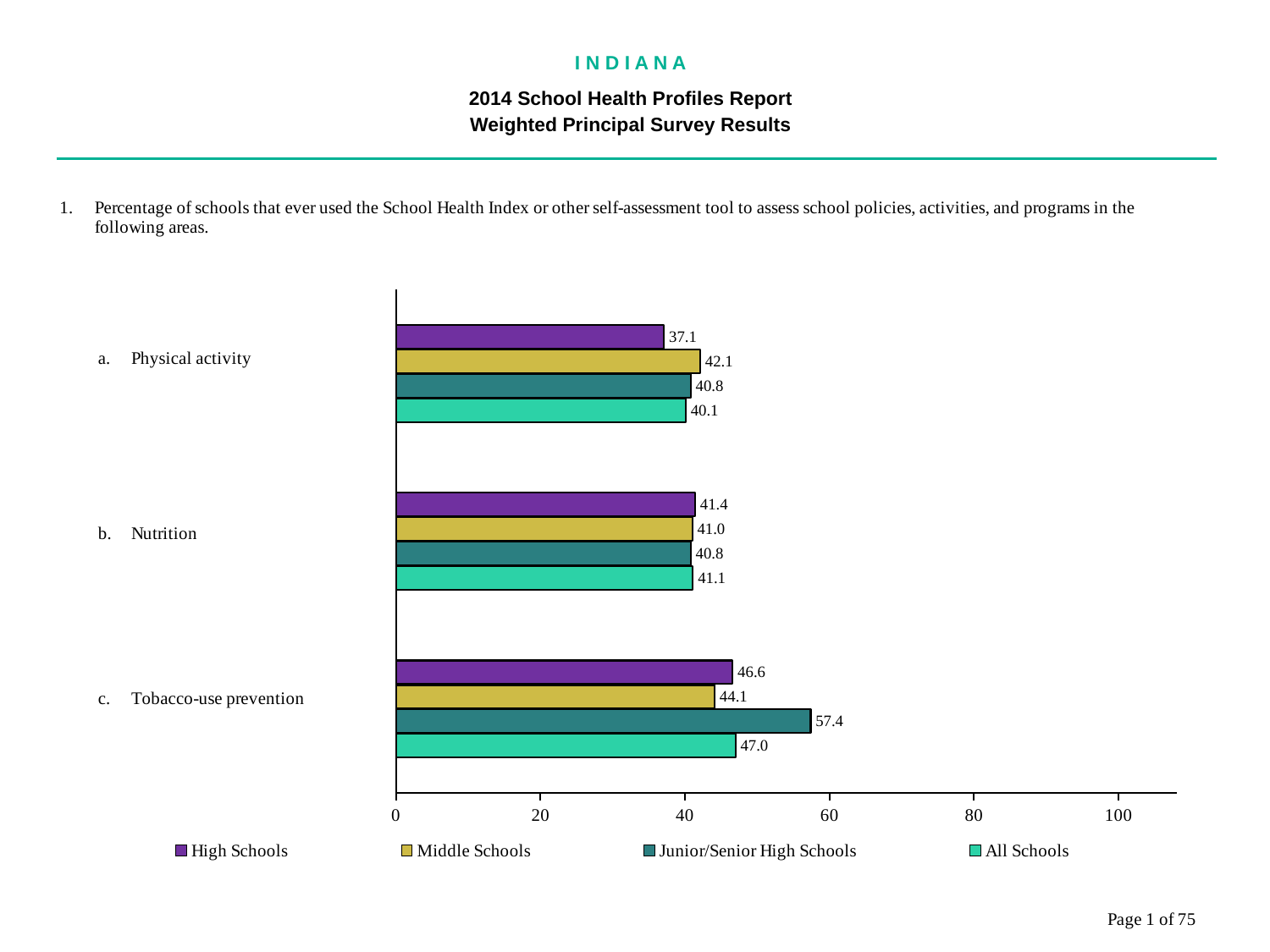
How many series does the legend list? 4 How many categories are shown on the chart? 3 Which is larger: the Middle Schools value for Physical activity or the Middle Schools value for Tobacco-use prevention? Tobacco-use prevention What is the value for Junior/Senior High Schools in the Tobacco-use prevention category? 57.4 What is the value for High Schools in the Physical activity category? 37.1 Which series has the lowest value in the Physical activity category? High Schools What is the difference between the Junior/Senior High Schools value and the Middle Schools value in the Tobacco-use prevention category? 13.3 What is the value for All Schools in the Nutrition category? 41.1 Is the value for Junior/Senior High Schools in the Tobacco-use prevention category greater or less than 40? greater Which series is shown in purple in the legend? High Schools Which series has the highest value in the Tobacco-use prevention category? Junior/Senior High Schools What kind of chart is shown on the slide? bar chart